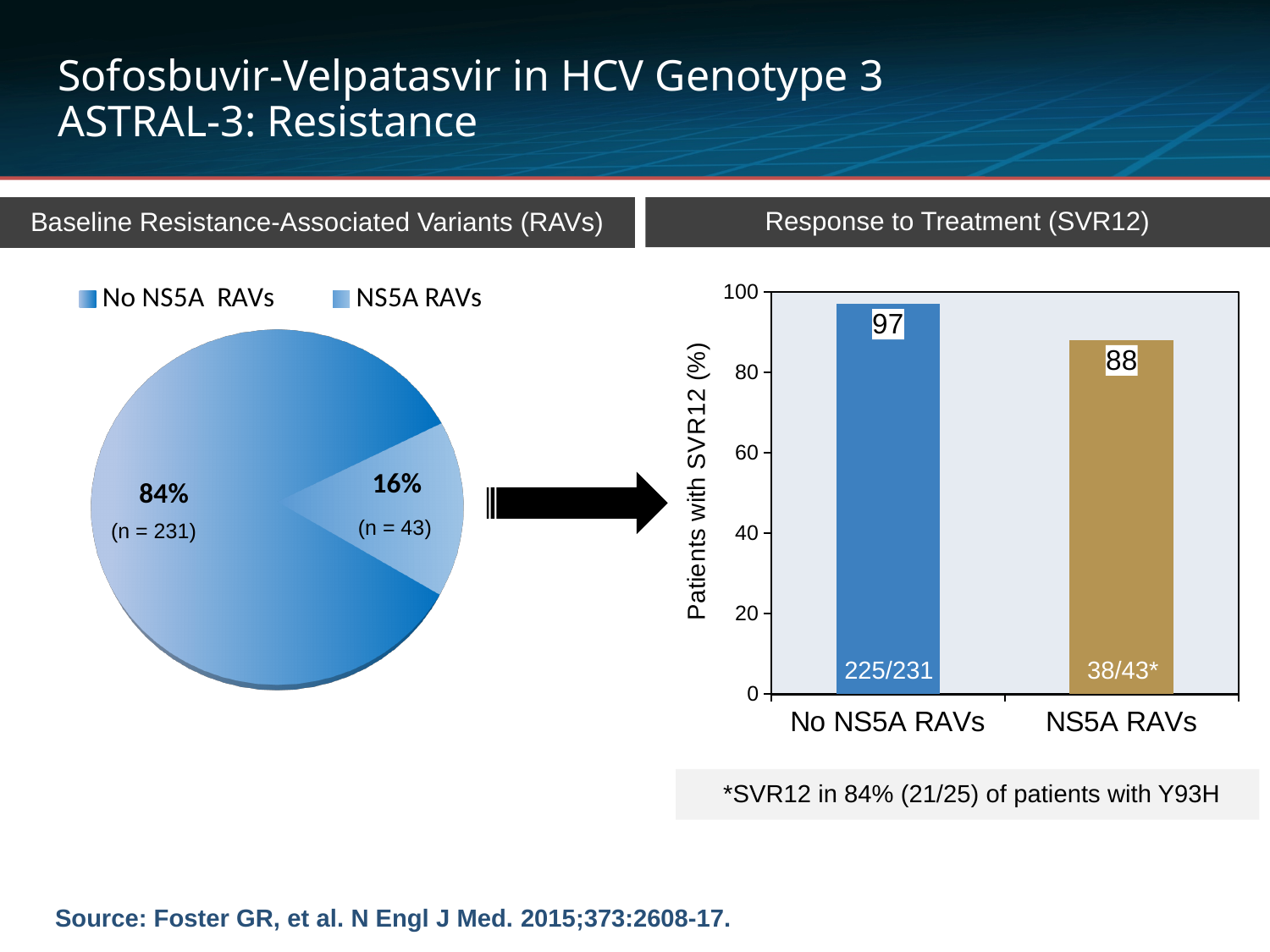
In the Response to Treatment (SVR12) chart, what percentage of patients with No NS5A RAVs achieved SVR12? 97 What kind of chart is shown under Response to Treatment (SVR12)? Bar chart In the Response to Treatment (SVR12) chart, what percentage of patients with NS5A RAVs achieved SVR12? 88 In the Baseline Resistance-Associated Variants (RAVs) pie chart, how many patients are in the No NS5A RAVs slice? n = 231 How many entries does the legend of the Baseline Resistance-Associated Variants (RAVs) pie chart list? 2 In the Baseline Resistance-Associated Variants (RAVs) pie chart, what share of patients had NS5A RAVs? 16% In the Baseline Resistance-Associated Variants (RAVs) pie chart, what share of patients had No NS5A RAVs? 84% In the Baseline Resistance-Associated Variants (RAVs) pie chart, how many patients are in the NS5A RAVs slice? n = 43 In the Response to Treatment (SVR12) chart, what is the difference in SVR12 percentage between No NS5A RAVs and NS5A RAVs? 9 What kind of chart is shown under Baseline Resistance-Associated Variants (RAVs)? Pie chart In the Response to Treatment (SVR12) chart, what fraction is printed on the NS5A RAVs bar? 38/43* In the Response to Treatment (SVR12) chart, which group has the higher SVR12 rate? No NS5A RAVs